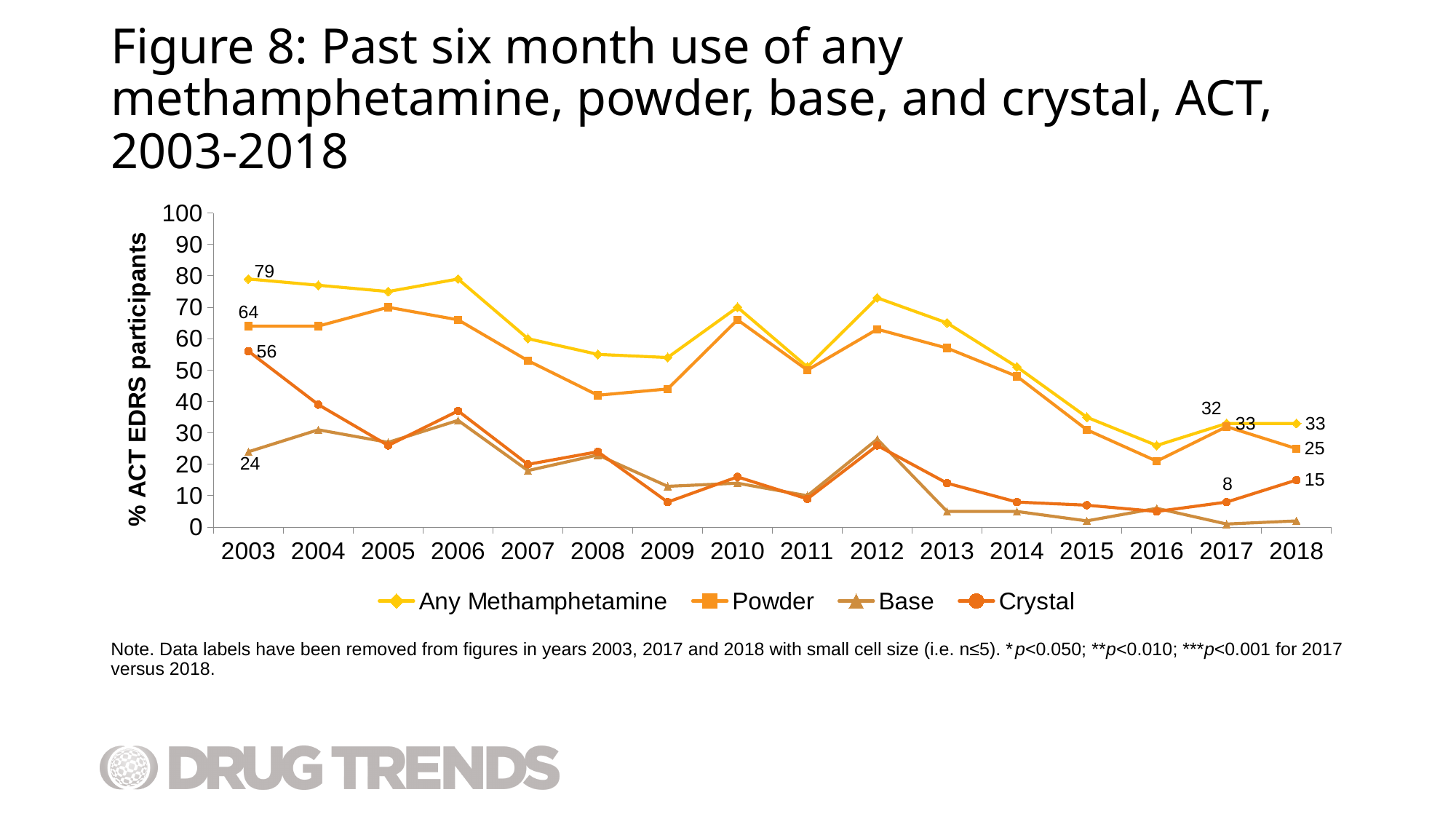
By how much did the Crystal value increase from 2017 to 2018? 7 What is the value for Base in 2003? 24 Which is larger in 2018, Powder or Crystal? Powder What is the value for Powder in 2018? 25 What is the value for Crystal in 2003? 56 What is the value for Crystal in 2017? 8 How many series does the legend list? 4 What is the value for Any Methamphetamine in 2003? 79 Is the value for Base in 2015 greater or less than 10? less What kind of chart is shown on the slide? line chart What is the value for Powder in 2003? 64 What is the value for Crystal in 2018? 15